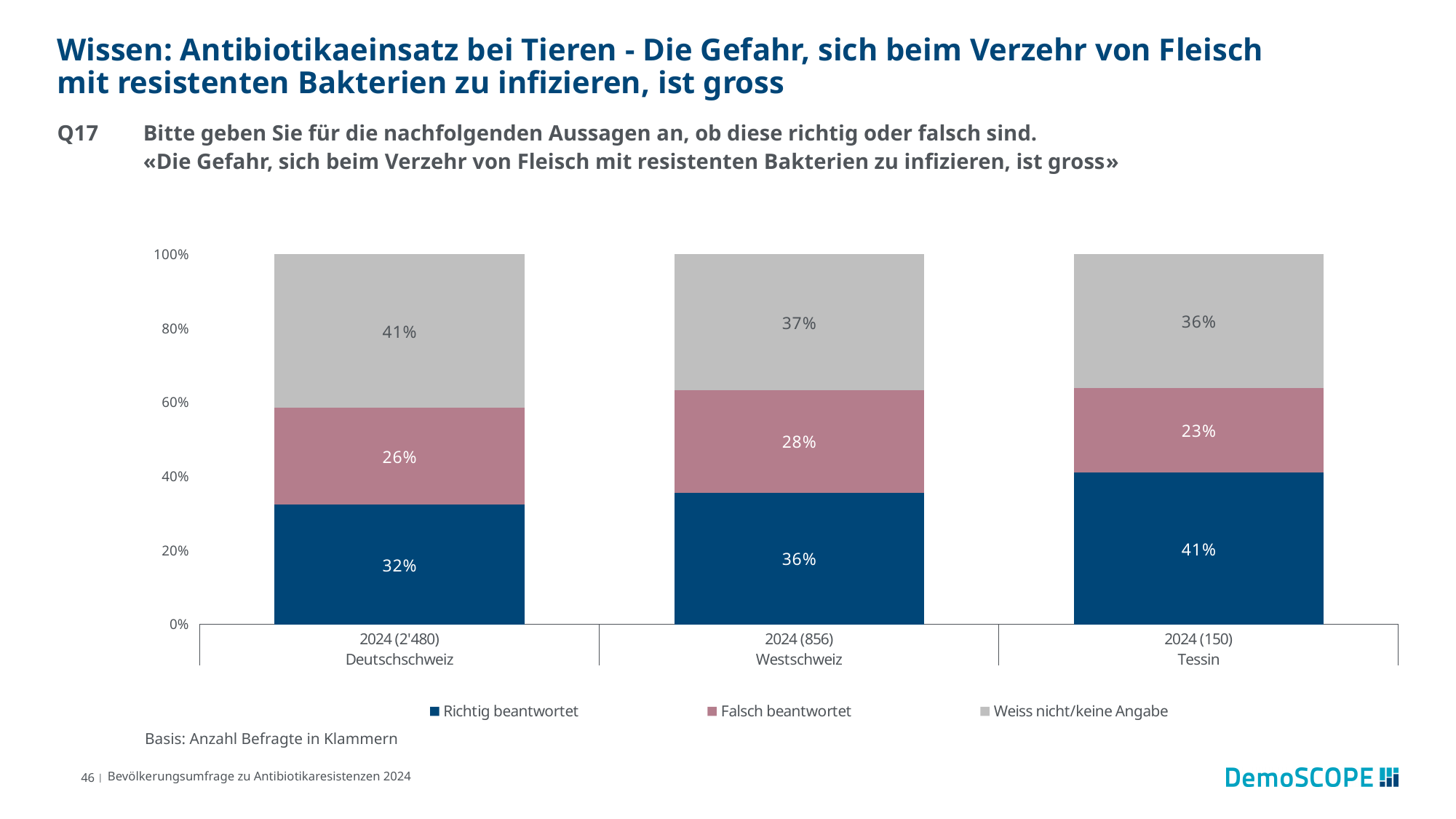
Which is larger: the 'Falsch beantwortet' share in Westschweiz or in Deutschschweiz? Westschweiz Which region has the highest share of 'Richtig beantwortet'? Tessin What is the 'Weiss nicht/keine Angabe' share for Westschweiz? 37% How does the 'Richtig beantwortet' share change from Deutschschweiz to Westschweiz to Tessin? It rises How many series does the legend list? 3 What type of chart is shown on the slide? Stacked bar chart How many respondents form the basis for the Westschweiz bar? 856 What percentage of respondents in Tessin answered incorrectly (Falsch beantwortet)? 23% How many regions (bars) are shown in the chart? 3 What is the difference in the 'Richtig beantwortet' share between Tessin and Deutschschweiz? 9 percentage points What percentage of respondents in Deutschschweiz answered correctly (Richtig beantwortet)? 32% Which region has the lowest share of 'Weiss nicht/keine Angabe'? Tessin